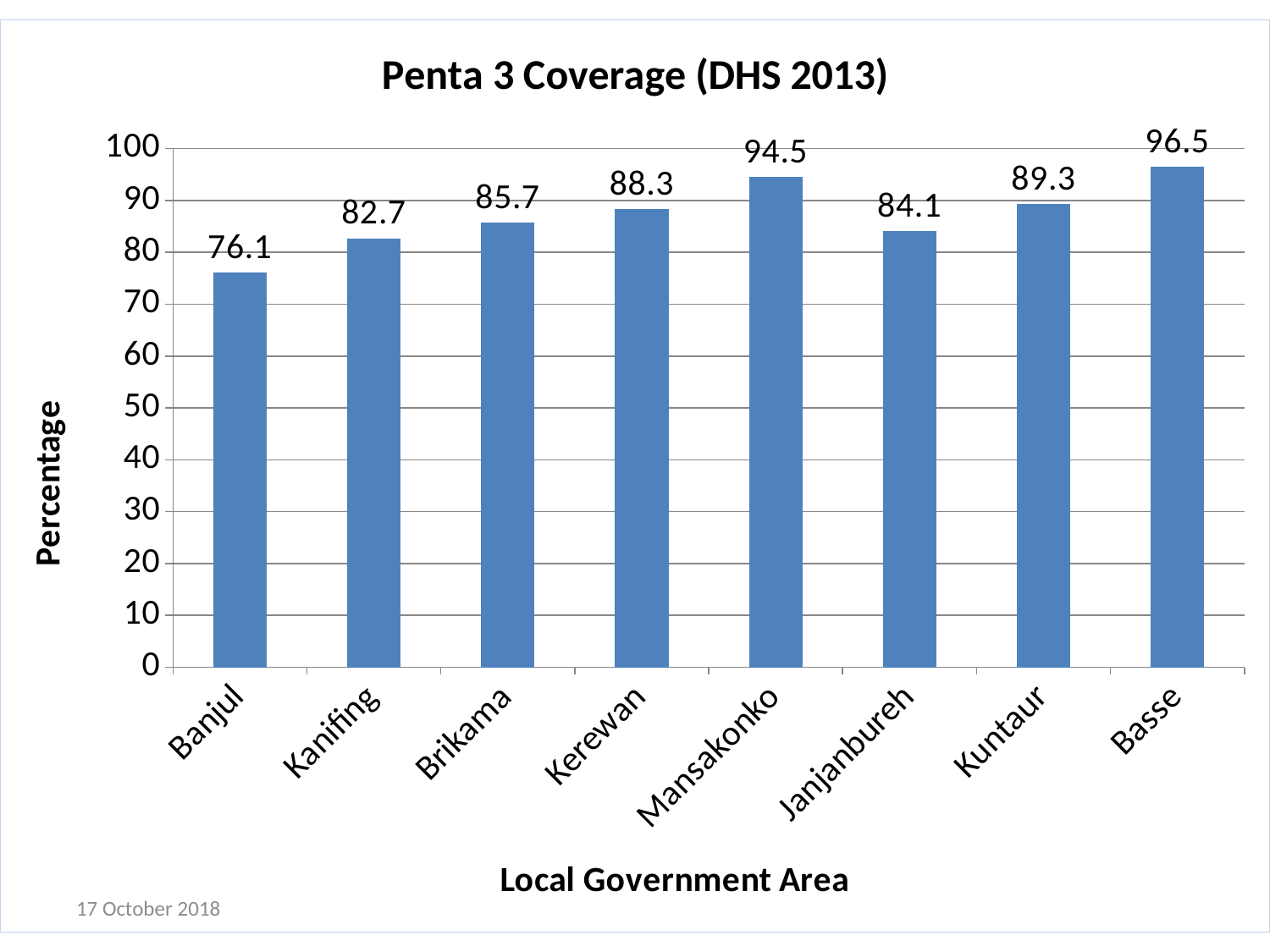
Is the Penta 3 coverage value for Kerewan greater or less than 80? greater What is the Penta 3 coverage value for Banjul? 76.1 What is the difference between the Penta 3 coverage values for Kuntaur and Kerewan? 1.0 Which Local Government Area has the highest Penta 3 coverage? Basse What is the title of the chart? Penta 3 Coverage (DHS 2013) What is the difference between the Penta 3 coverage values for Basse and Banjul? 20.4 What is the Penta 3 coverage value for Mansakonko? 94.5 What kind of chart is shown on the slide? Bar chart Which Local Government Area has the lowest Penta 3 coverage? Banjul Which has a higher Penta 3 coverage, Brikama or Kanifing? Brikama What is the Penta 3 coverage value for Janjanbureh? 84.1 How many Local Government Areas are shown on the chart? 8